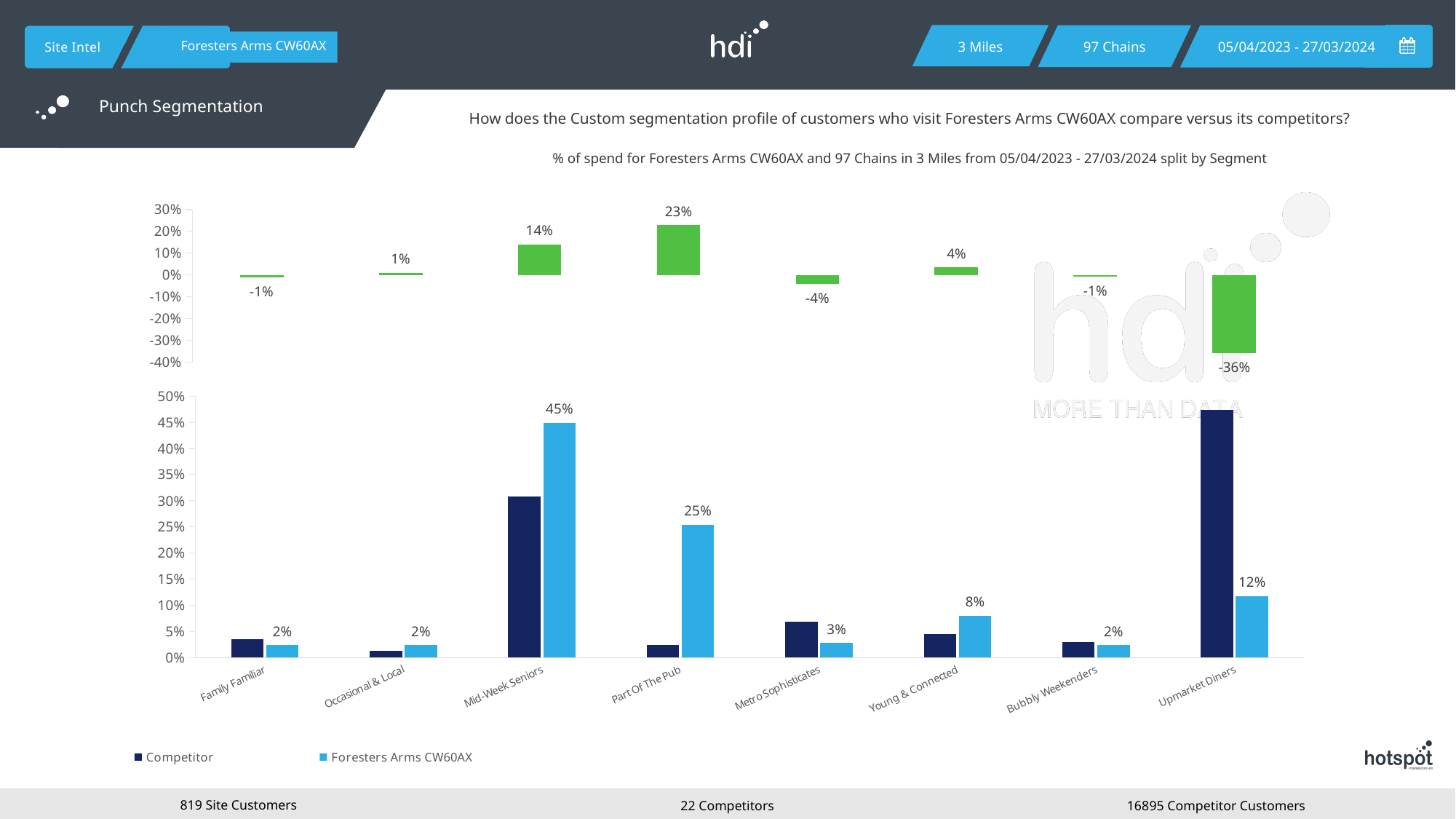
In the bottom chart, what is the Foresters Arms CW60AX value for Mid-Week Seniors? 45% In the top chart, what is the value shown for Upmarket Diners? -36% In the top chart, which segment has the lowest value? Upmarket Diners In the bottom chart, what is the difference between the Foresters Arms CW60AX values for Mid-Week Seniors and Part Of The Pub? 20 percentage points What kind of chart is the bottom chart? bar chart In the bottom chart, for Upmarket Diners, which is larger: the Competitor value or the Foresters Arms CW60AX value? Competitor How many series does the legend of the bottom chart list? 2 In the bottom chart, is the Competitor value for Mid-Week Seniors greater or less than 25%? greater In the top chart, which segment has the highest value? Part Of The Pub In the bottom chart, is the Competitor value for Upmarket Diners greater or less than 40%? greater In the bottom chart, which segment has the highest Foresters Arms CW60AX value? Mid-Week Seniors How many segment categories are shown on the x axis of the bottom chart? 8